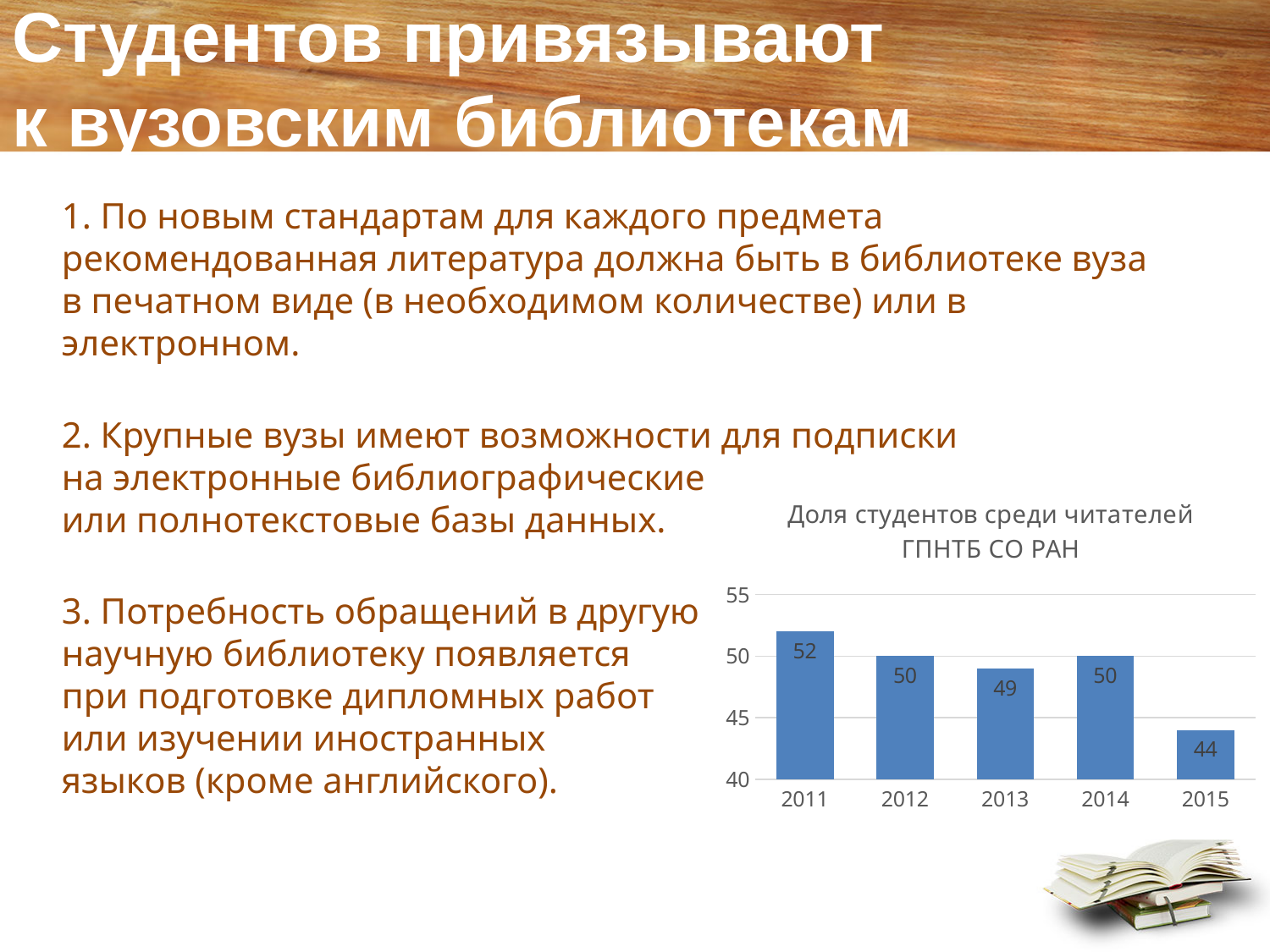
Which year has the highest value? 2011 What is the title of the chart? Доля студентов среди читателей ГПНТБ СО РАН What is the value for 2011? 52 Is the value for 2015 greater or less than 45? less How many years are shown on the x axis? 5 Do the values generally rise or fall from 2011 to 2015? fall What kind of chart is shown? bar chart Which year has the lowest value? 2015 What is the value for 2013? 49 What is the difference between the values for 2011 and 2015? 8 Which is larger, the value for 2013 or the value for 2014? 2014 What is the value for 2015? 44